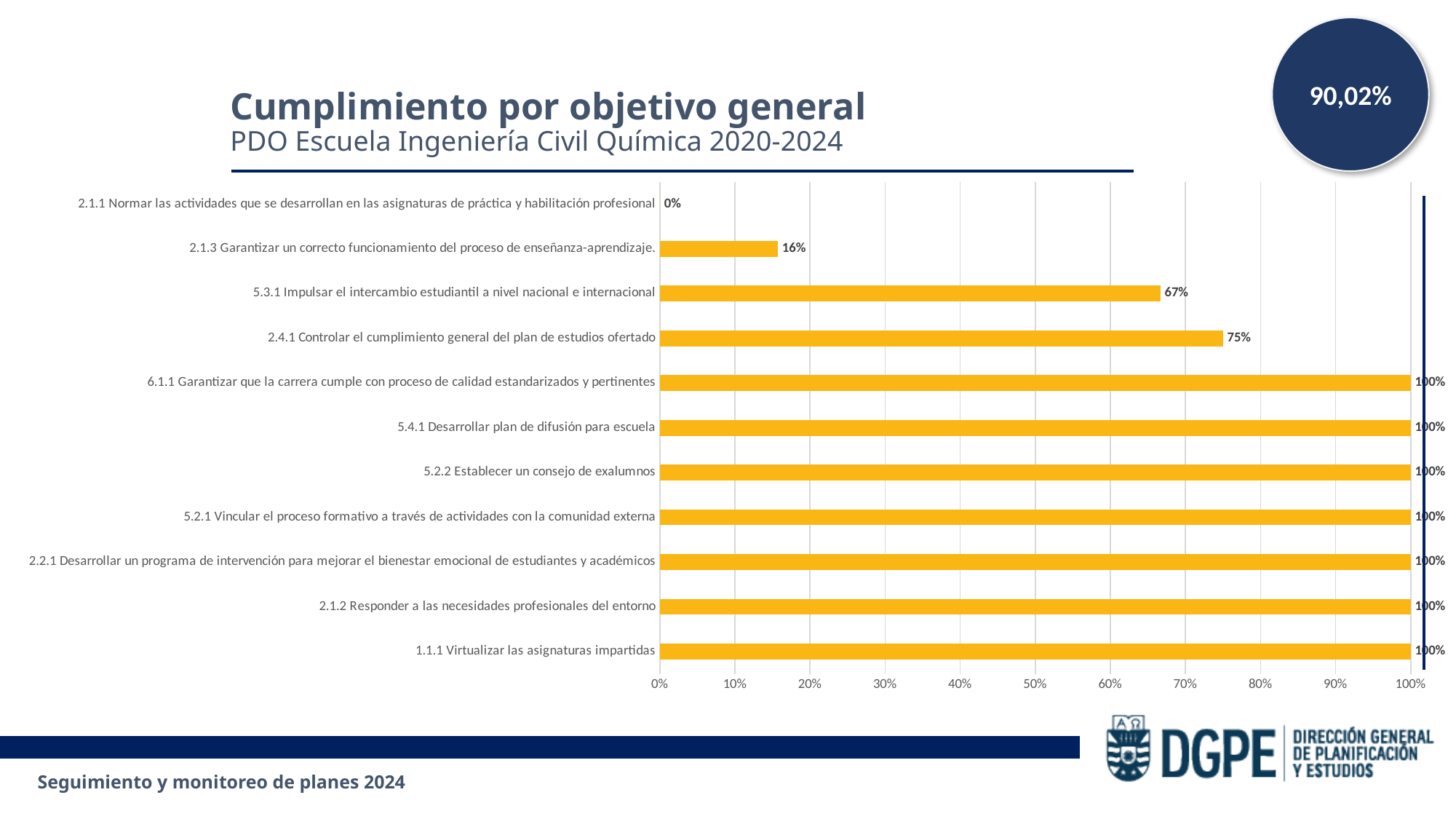
What kind of chart is shown on the slide? Bar chart What is the value for 2.4.1 Controlar el cumplimiento general del plan de estudios ofertado? 75% What is the value for 5.3.1 Impulsar el intercambio estudiantil a nivel nacional e internacional? 67% Which is larger: the value for 2.1.3 Garantizar un correcto funcionamiento del proceso de enseñanza-aprendizaje or the value for 5.3.1 Impulsar el intercambio estudiantil a nivel nacional e internacional? 5.3.1 Impulsar el intercambio estudiantil a nivel nacional e internacional How many categories are shown in the chart? 11 What is the title of the chart? Cumplimiento por objetivo general How many categories have a value of 100%? 7 Which category has the lowest value? 2.1.1 Normar las actividades que se desarrollan en las asignaturas de práctica y habilitación profesional What is the value for 2.1.3 Garantizar un correcto funcionamiento del proceso de enseñanza-aprendizaje? 16% What is the value for 2.1.1 Normar las actividades que se desarrollan en las asignaturas de práctica y habilitación profesional? 0% What is the difference between the values for 2.4.1 Controlar el cumplimiento general del plan de estudios ofertado and 5.3.1 Impulsar el intercambio estudiantil a nivel nacional e internacional? 8% Is the value for 5.3.1 Impulsar el intercambio estudiantil a nivel nacional e internacional greater or less than 50%? greater